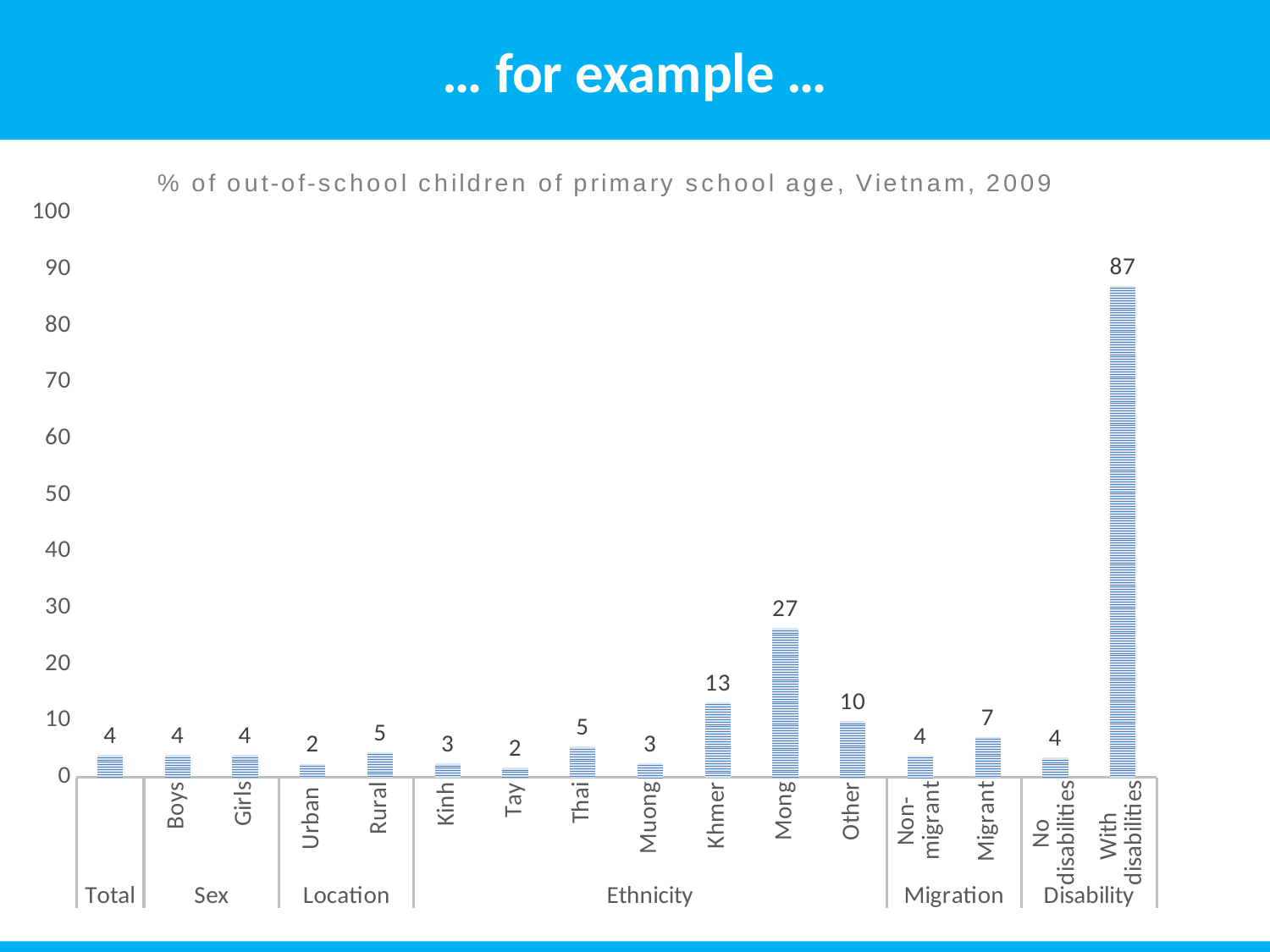
Which category has the highest value? With disabilities What kind of chart is shown on the slide? Bar chart Is the value for Mong greater or less than 20? greater What is the difference between the values for Rural and Urban? 3 Which is larger, the value for Mong or the value for Khmer? Mong What is the title of the chart? % of out-of-school children of primary school age, Vietnam, 2009 What is the value for Mong? 27 What is the value for Khmer? 13 How many bars are plotted in the chart? 16 What is the difference between the values for With disabilities and No disabilities? 83 What is the value for Migrant? 7 What is the value for With disabilities? 87